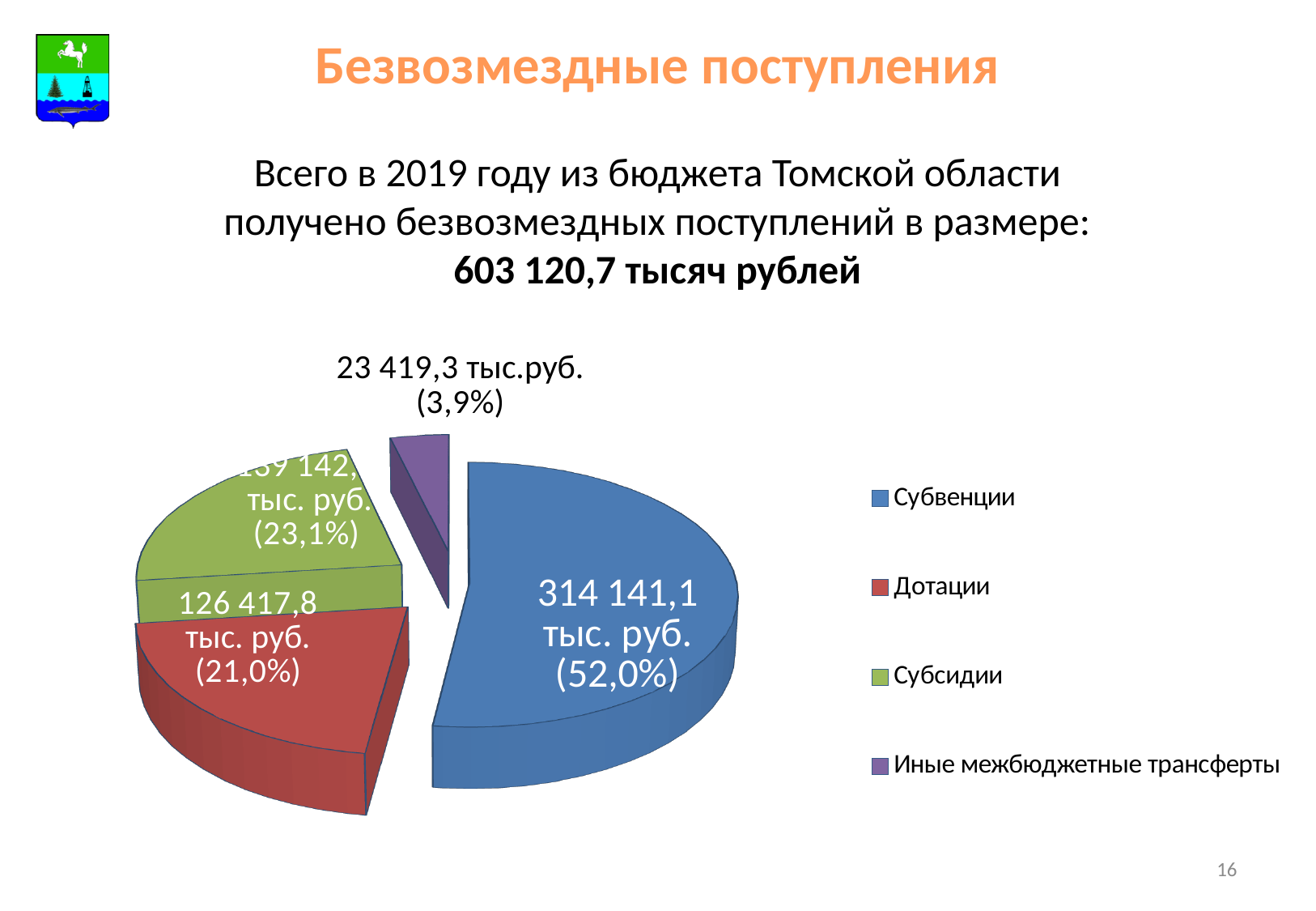
Which category has the smallest slice of the pie? Иные межбюджетные трансферты What is the value shown for Дотации? 126 417,8 тыс. руб. What share of the pie does Субвенции represent? 52,0% What colour is used for Субсидии in the legend? Green Which category has the largest slice of the pie? Субвенции What is the value shown for Субвенции? 314 141,1 тыс. руб. How many slices does the pie chart have? 4 What is the value shown for Иные межбюджетные трансферты? 23 419,3 тыс.руб. What share of the pie does Дотации represent? 21,0% Which is larger, the value for Дотации or the value for Иные межбюджетные трансферты? Дотации What kind of chart is shown on the slide? Pie chart What share of the pie does Субсидии represent? 23,1%